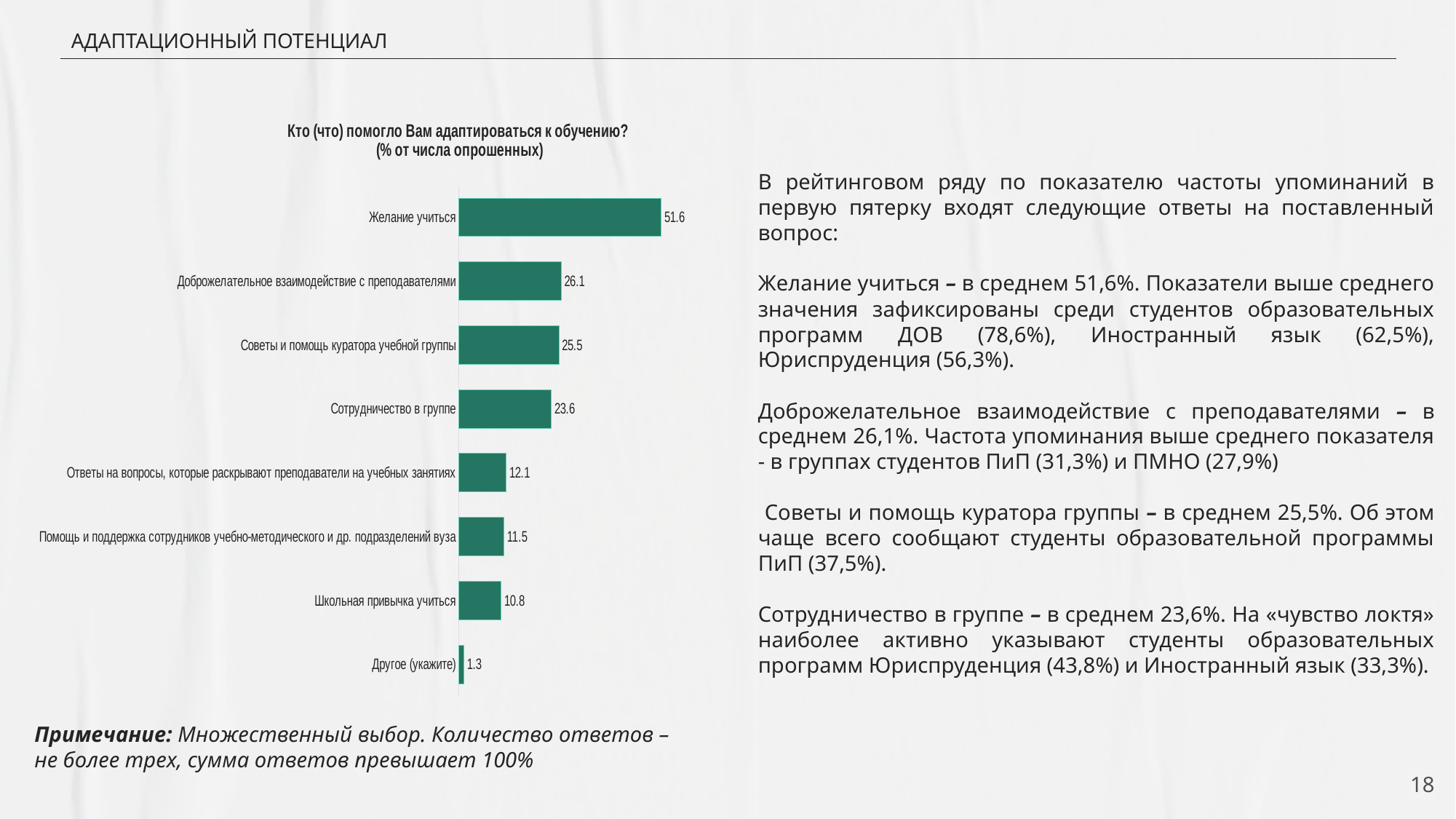
What is the title of the chart? Кто (что) помогло Вам адаптироваться к обучению? (% от числа опрошенных) What is the difference between «Желание учиться» and «Доброжелательное взаимодействие с преподавателями»? 25.5 What is the value for «Желание учиться»? 51.6 Which is larger: «Советы и помощь куратора учебной группы» or «Сотрудничество в группе»? Советы и помощь куратора учебной группы How many categories are shown in the chart? 8 What is the value for «Сотрудничество в группе»? 23.6 What is the value for «Школьная привычка учиться»? 10.8 What colour are the bars in the chart? Green Which category has the highest value? Желание учиться Which category has the lowest value? Другое (укажите) What kind of chart is shown on the slide? Bar chart What is the difference between «Ответы на вопросы, которые раскрывают преподаватели на учебных занятиях» and «Помощь и поддержка сотрудников учебно-методического и др. подразделений вуза»? 0.6